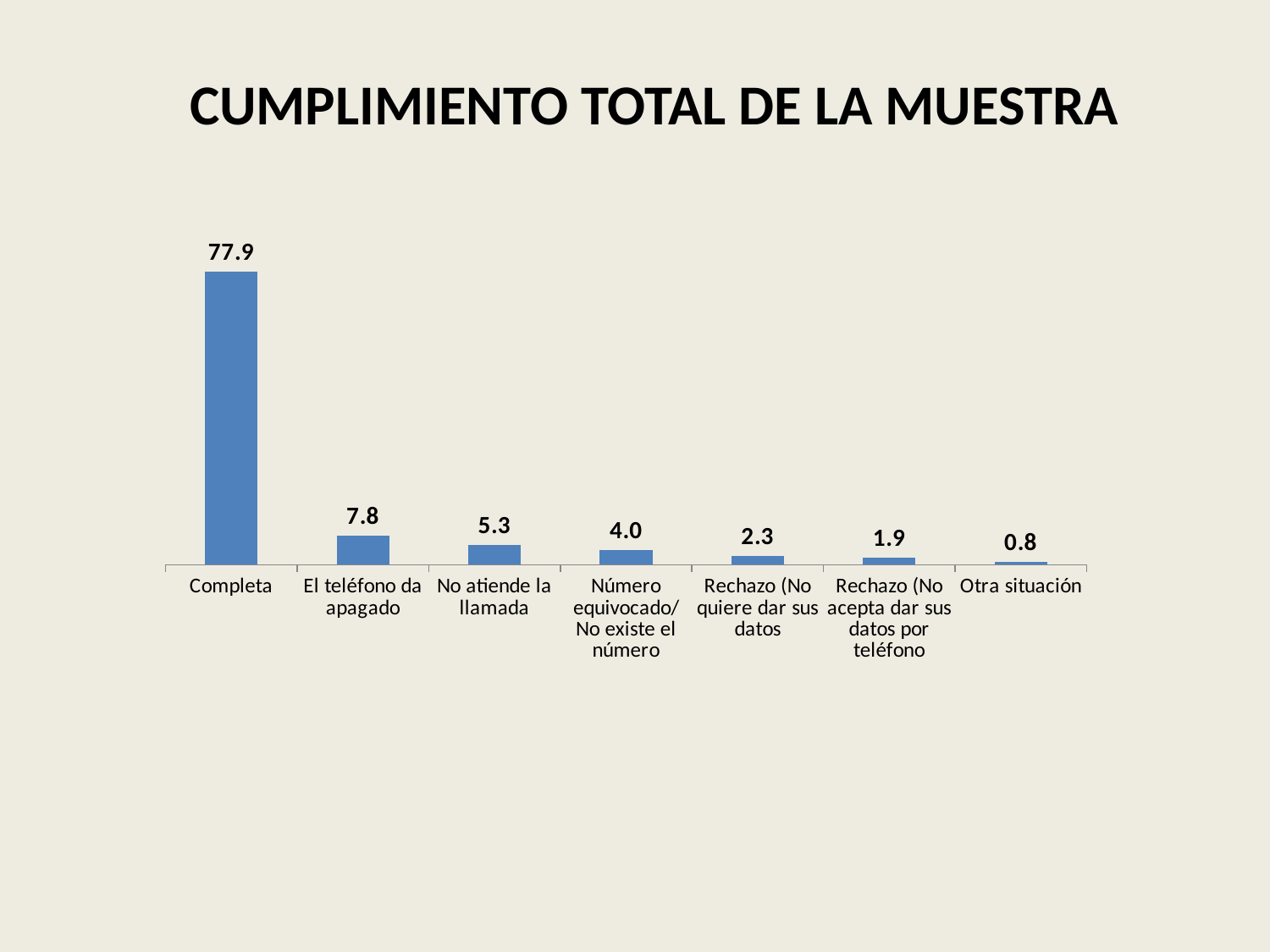
What is the title of the chart? CUMPLIMIENTO TOTAL DE LA MUESTRA Which is larger, the value for No atiende la llamada or the value for Número equivocado/No existe el número? No atiende la llamada What is the difference between the values for Rechazo (No quiere dar sus datos and Rechazo (No acepta dar sus datos por teléfono? 0.4 What is the value for No atiende la llamada? 5.3 What is the difference between the values for Completa and El teléfono da apagado? 70.1 What is the value for Completa? 77.9 What is the value for El teléfono da apagado? 7.8 What kind of chart is shown on the slide? Bar chart What is the value for Otra situación? 0.8 Which category has the lowest value? Otra situación Which category has the highest value? Completa How many categories are shown on the x axis? 7